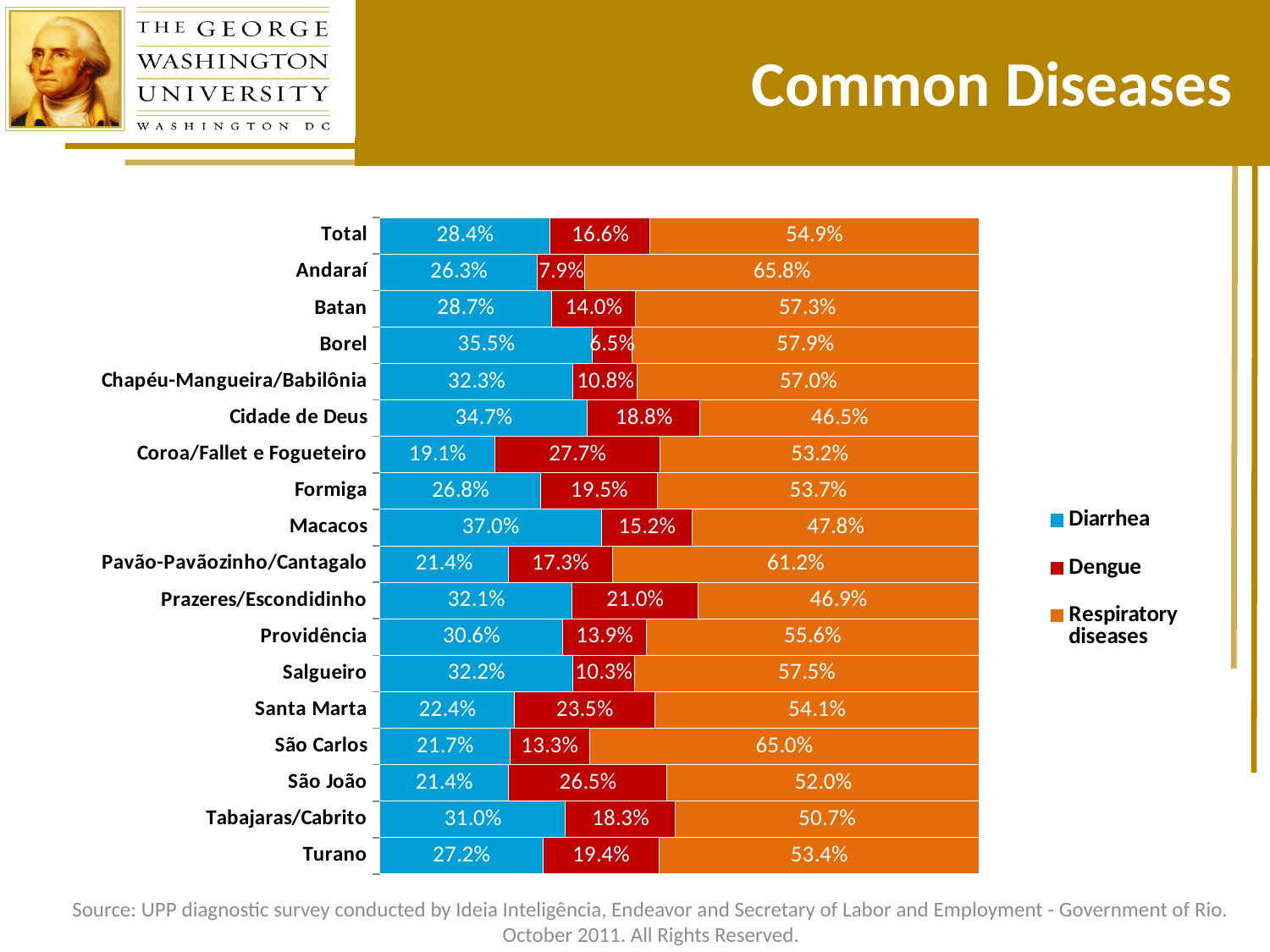
What is the Dengue value for Pavão-Pavãozinho/Cantagalo? 17.3% What is the Diarrhea value for Cidade de Deus? 34.7% What is the Respiratory diseases value for Tabajaras/Cabrito? 50.7% How many categories (rows) are plotted in the chart? 18 What is the difference between the Respiratory diseases value and the Diarrhea value for Total? 26.5% What is the title of the chart? Common Diseases Which category has the highest Respiratory diseases value? Andaraí Which category has the lowest Dengue value? Borel Which category has the highest Diarrhea value? Macacos How many series does the legend list? 3 Which has the larger Dengue value, Santa Marta or São Carlos? Santa Marta What kind of chart is shown on the slide? Stacked bar chart